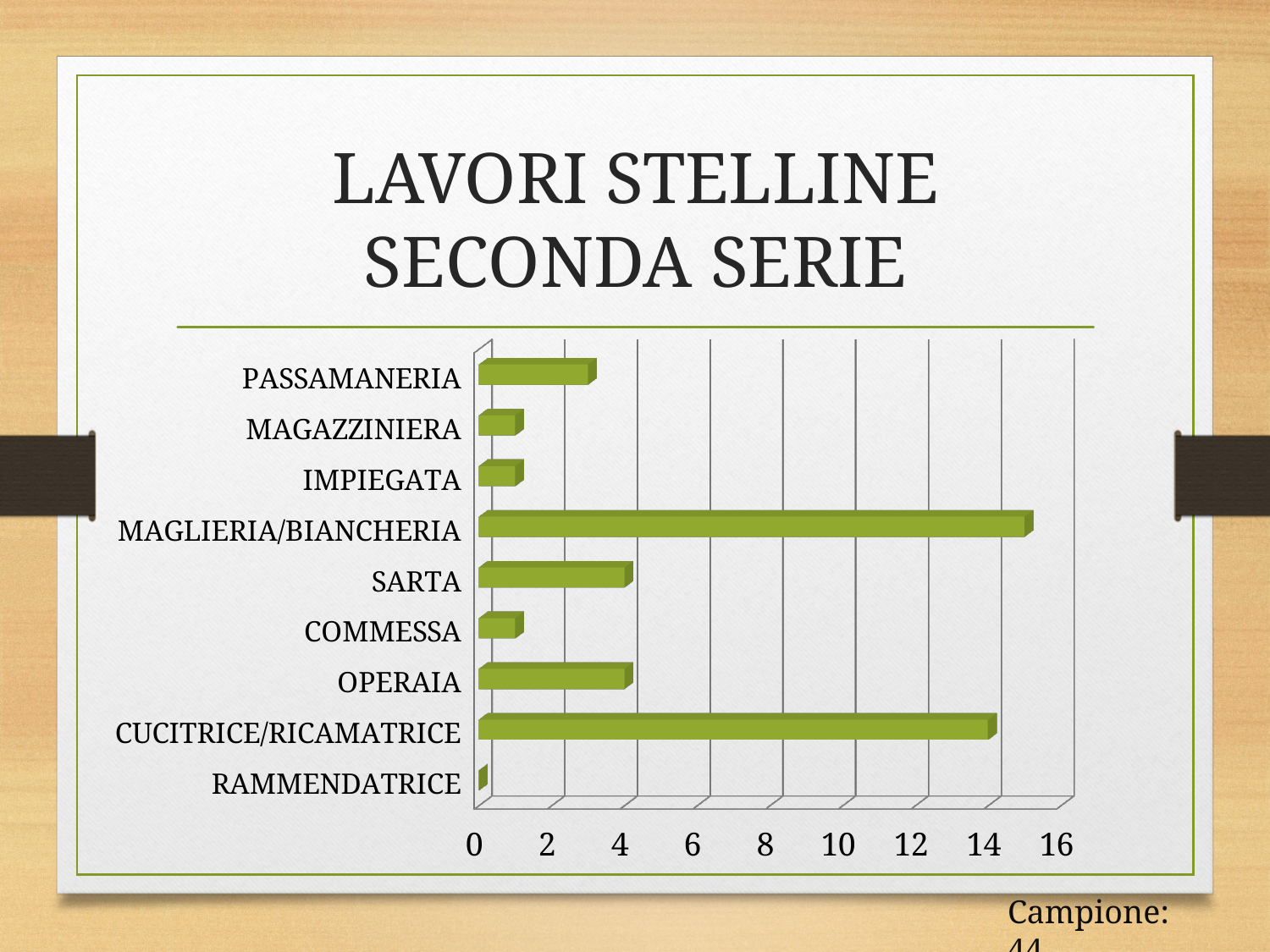
Is the value for MAGAZZINIERA greater or less than 2? less Which is larger, the value for SARTA or the value for PASSAMANERIA? SARTA What kind of chart is shown on the slide? bar chart Which category has the lowest value? RAMMENDATRICE Is the value for SARTA greater or less than 2? greater Which category has the highest value? MAGLIERIA/BIANCHERIA Is the value for MAGLIERIA/BIANCHERIA greater or less than 14? greater What is the title of the slide containing the chart? LAVORI STELLINE SECONDA SERIE Which is larger, the value for CUCITRICE/RICAMATRICE or the value for OPERAIA? CUCITRICE/RICAMATRICE How many categories are plotted in the chart? 9